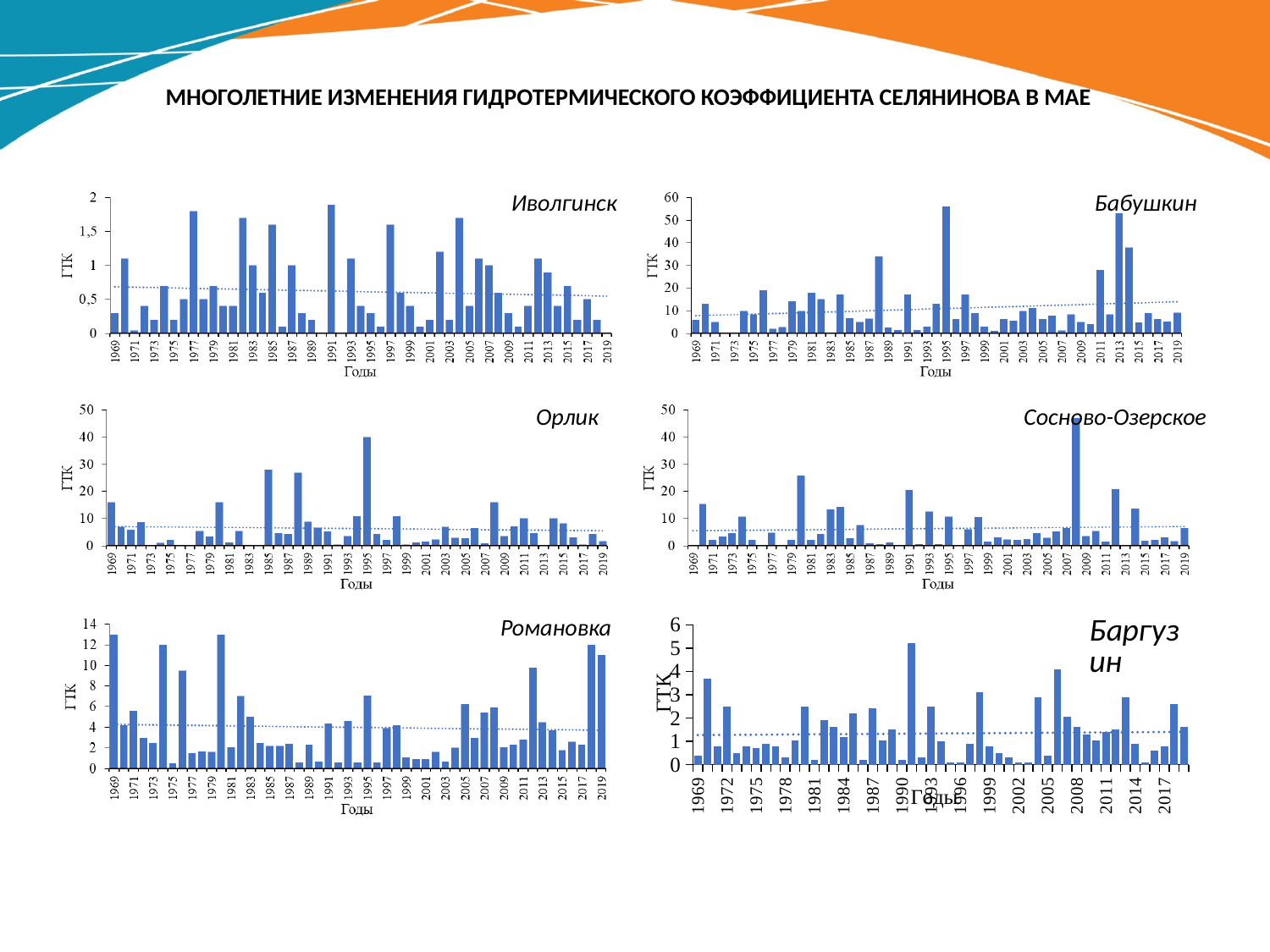
In the Иволгинск chart, is the value for 1977 greater or less than 1.5? greater In the Орлик chart, is the value for 1985 greater or less than 20? greater How many charts are shown on the slide? 6 In the Сосново-Озерское chart, which year has the highest value? 2008 In the Романовка chart, is the value for 1975 greater or less than 8? greater What label is shown on the vertical axis of the Романовка chart? ГТК In the Сосново-Озерское chart, which is larger, the value for 2008 or the value for 1991? 2008 In the Орлик chart, which is larger, the value for 1995 or the value for 1987? 1995 What kind of chart is used for the Иволгинск panel? bar chart In the Баргузин chart, which year has the highest value? 1991 In the Орлик chart, which year has the highest value? 1995